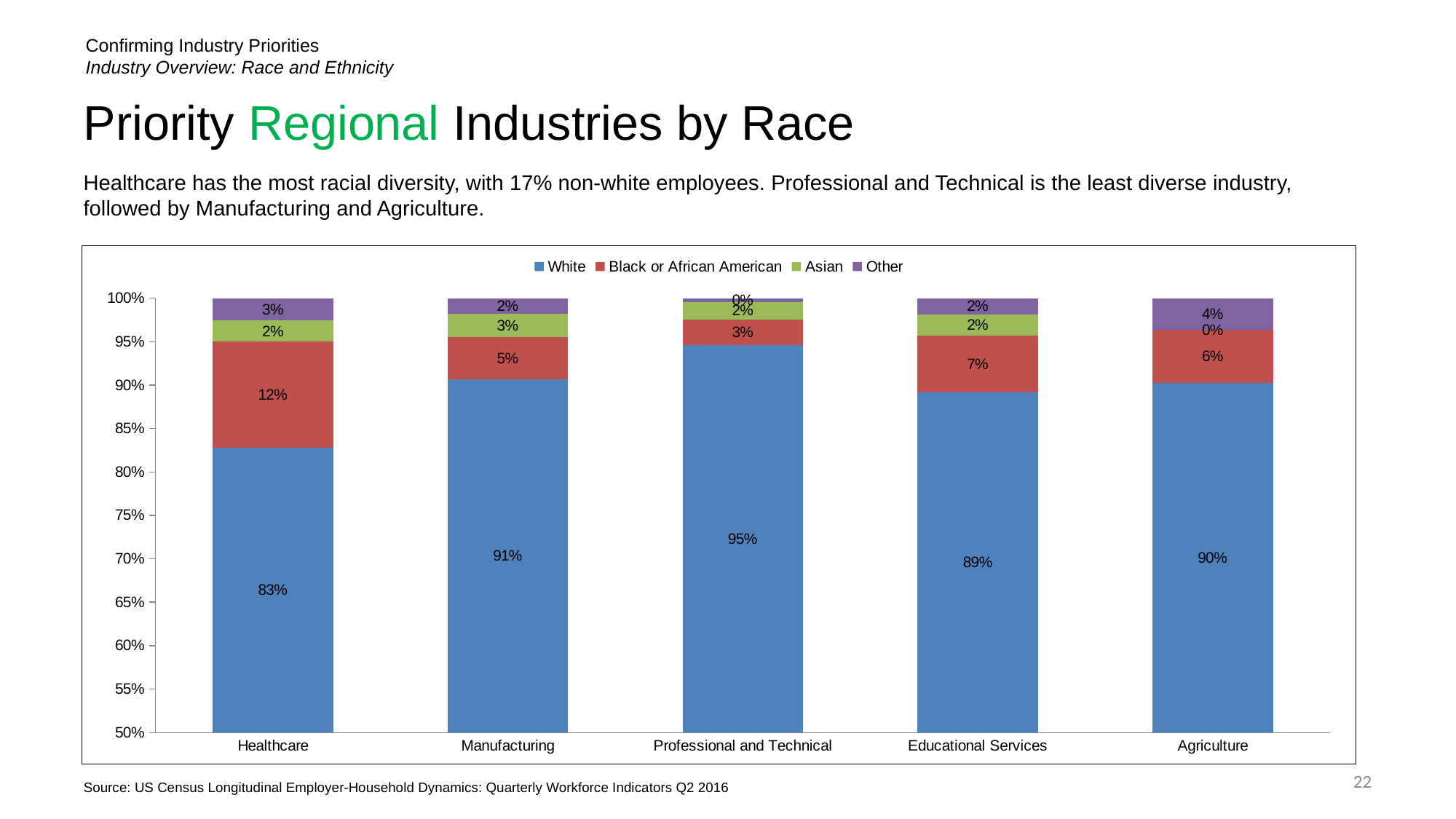
What percentage of Manufacturing employees are Black or African American? 5% What is the Asian share for Educational Services? 2% How many industries are shown on the x axis? 5 Which has a larger White share, Manufacturing or Agriculture? Manufacturing What is the Other share for Agriculture? 4% What kind of chart is shown? Stacked bar chart Which industry has the highest White share? Professional and Technical What percentage of Healthcare employees are White? 83% How many series does the legend list? 4 What is the difference between the Black or African American share in Healthcare and in Educational Services? 5% Which colour represents the Asian series in the legend? Green Which industry has the lowest White share? Healthcare